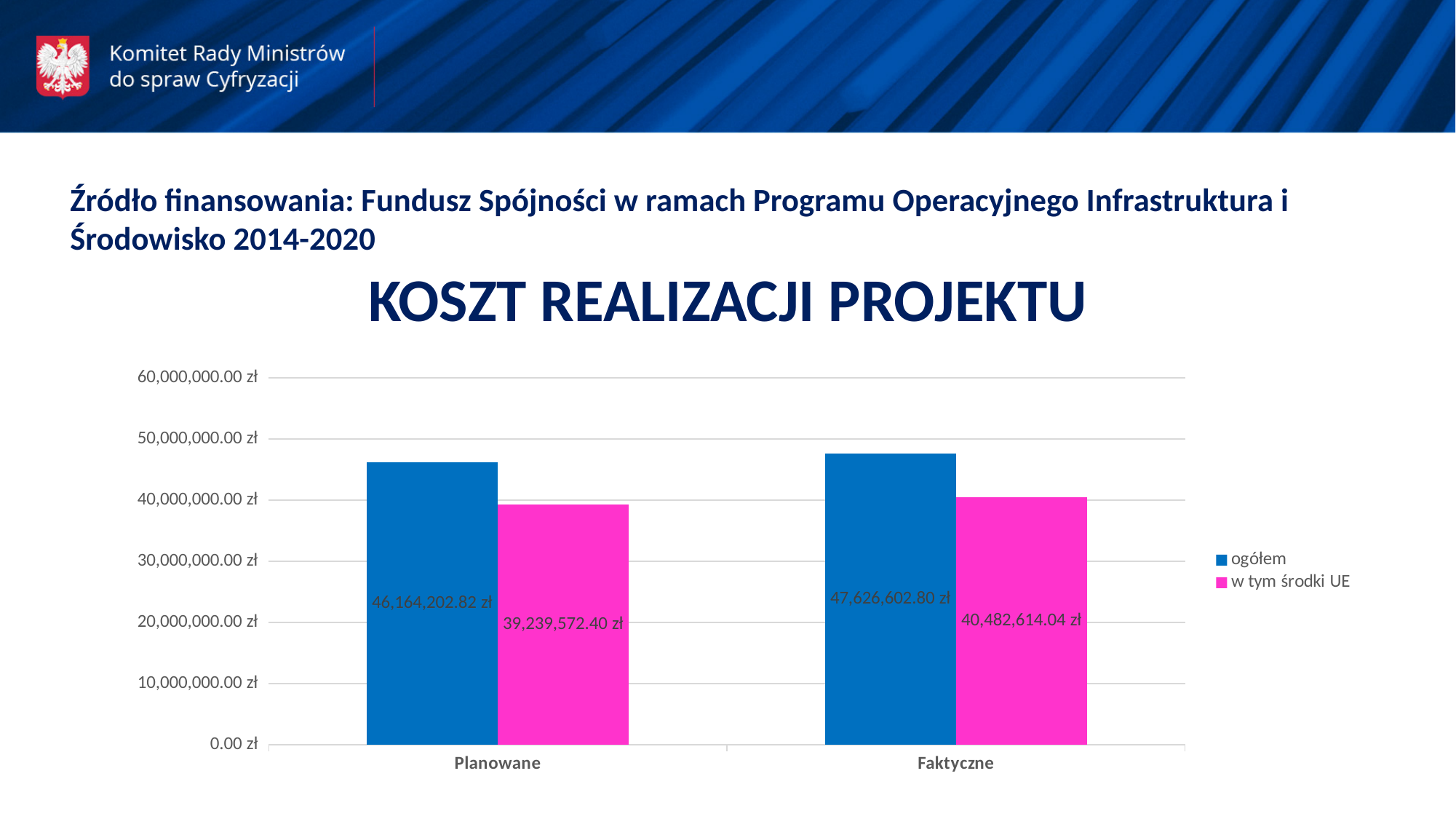
What is the value of ogółem for Faktyczne? 47,626,602.80 zł What is the value of ogółem for Planowane? 46,164,202.82 zł How many categories are shown on the x axis? 2 What type of chart is shown on the slide? bar chart Which category has the higher ogółem value? Faktyczne Which bar in the chart has the lowest value? w tym środki UE for Planowane What is the value of w tym środki UE for Faktyczne? 40,482,614.04 zł What is the difference between the ogółem values for Faktyczne and Planowane? 1,462,399.98 zł Is the w tym środki UE value for Faktyczne larger or smaller than the w tym środki UE value for Planowane? larger What is the value of w tym środki UE for Planowane? 39,239,572.40 zł For Faktyczne, what is the difference between ogółem and w tym środki UE? 7,143,988.76 zł How many series does the legend list? 2